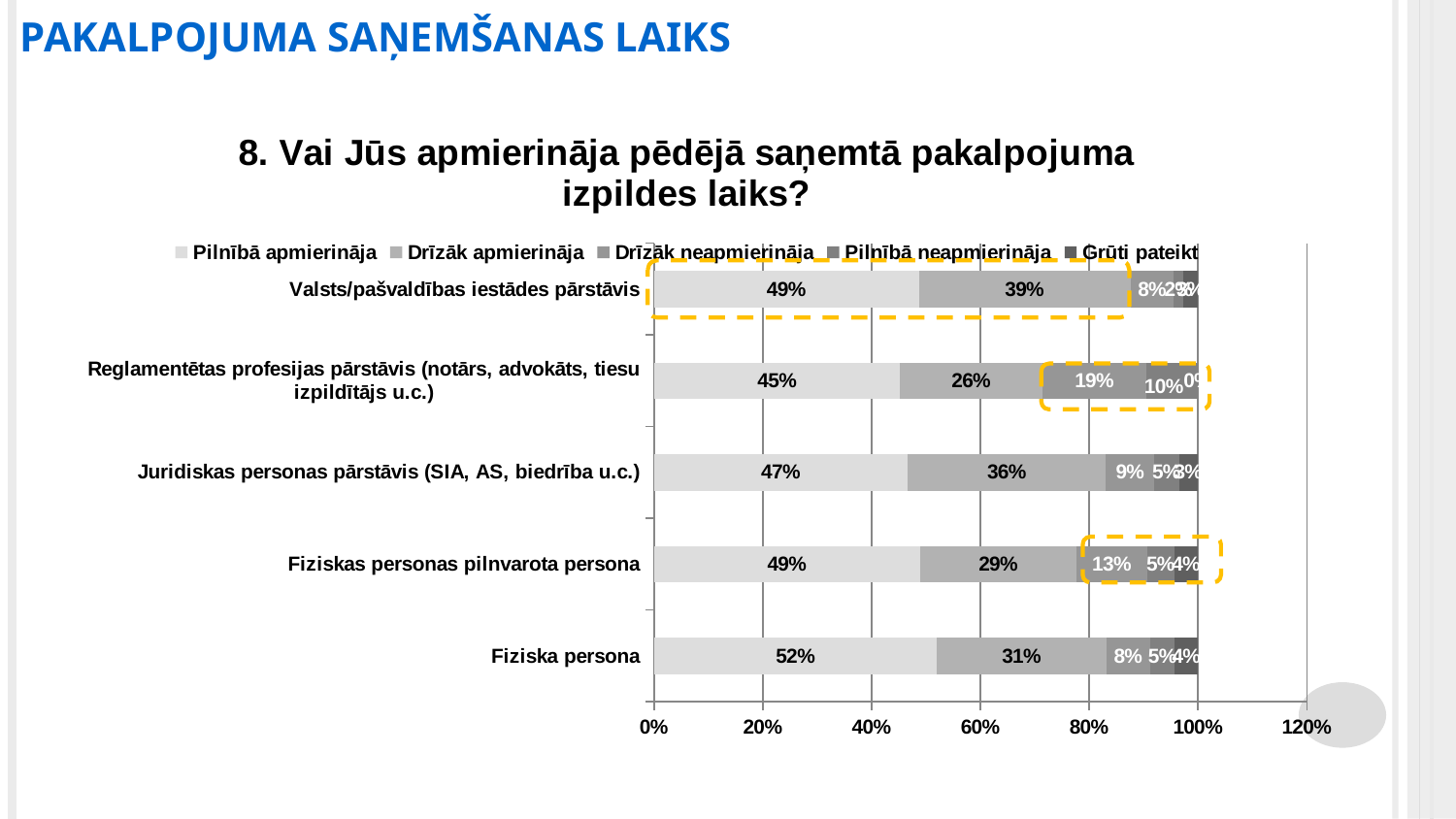
What is the value of "Drīzāk neapmierināja" for "Fiziskas personas pilnvarota persona"? 13% Which is larger: the "Drīzāk apmierināja" value for "Juridiskas personas pārstāvis (SIA, AS, biedrība u.c.)" or for "Fiziska persona"? Juridiskas personas pārstāvis (SIA, AS, biedrība u.c.) Which category has the highest value for "Pilnībā apmierināja"? Fiziska persona What is the value of "Drīzāk neapmierināja" for "Reglamentētas profesijas pārstāvis (notārs, advokāts, tiesu izpildītājs u.c.)"? 19% What is the value of "Drīzāk apmierināja" for "Valsts/pašvaldības iestādes pārstāvis"? 39% How many series does the legend list? 5 What is the difference between the "Drīzāk apmierināja" values for "Valsts/pašvaldības iestādes pārstāvis" and "Reglamentētas profesijas pārstāvis (notārs, advokāts, tiesu izpildītājs u.c.)"? 13% What is the value of "Pilnībā apmierināja" for "Fiziska persona"? 52% How many respondent categories are shown on the chart? 5 What type of chart is shown on the slide? Stacked bar chart Which category has the lowest value for "Pilnībā apmierināja"? Reglamentētas profesijas pārstāvis (notārs, advokāts, tiesu izpildītājs u.c.) What is the title of the chart? 8. Vai Jūs apmierināja pēdējā saņemtā pakalpojuma izpildes laiks?